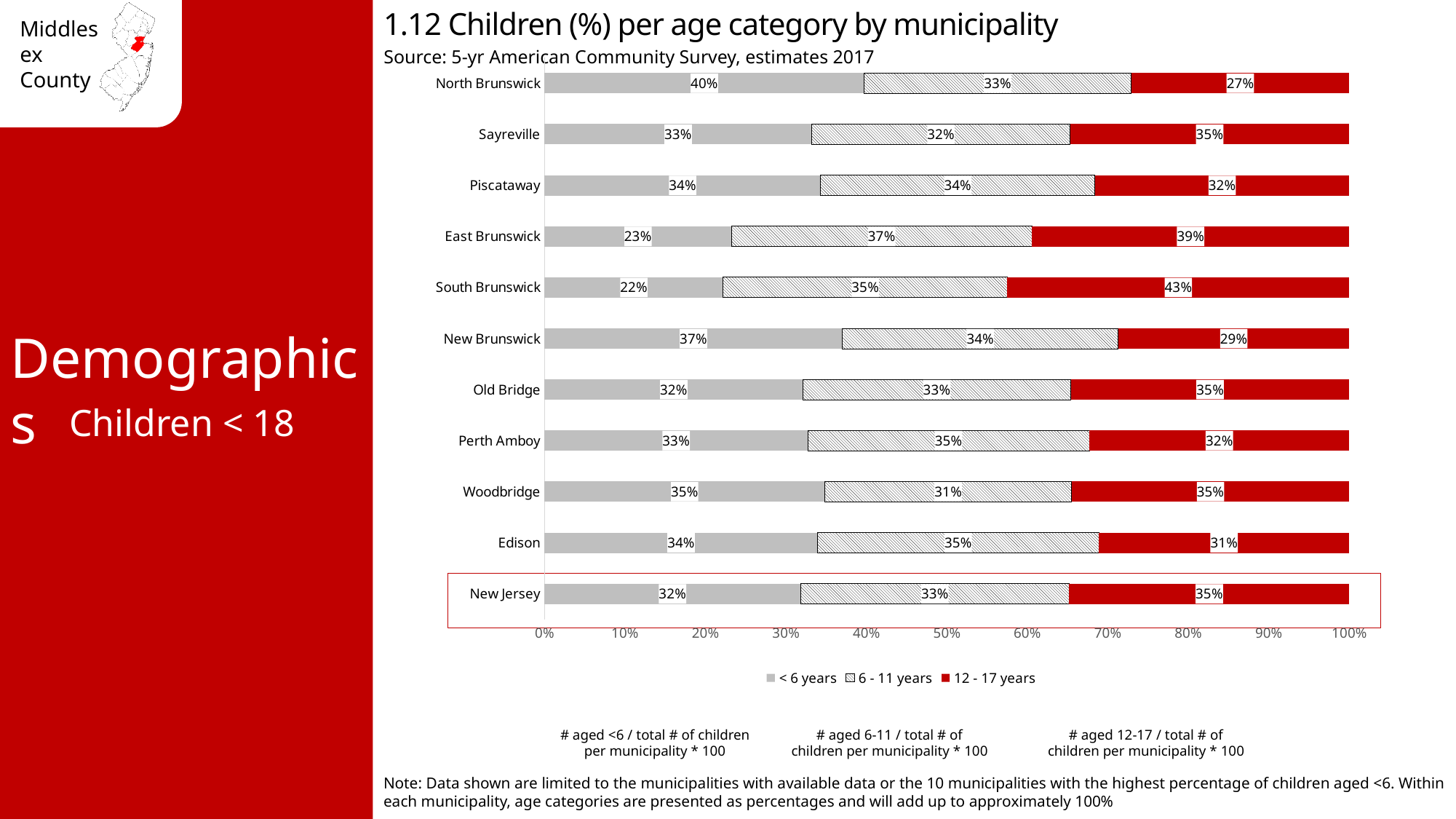
What kind of chart is shown on the slide? Stacked bar chart Which is larger: the 12 - 17 years value for East Brunswick or for New Brunswick? East Brunswick Which category has the lowest value for the 12 - 17 years series? North Brunswick Which municipality has the highest percentage of children under 6 years? North Brunswick Which municipality has the lowest percentage of children under 6 years? South Brunswick What percentage of children in North Brunswick are under 6 years old? 40% What is the value for the 12 - 17 years series for South Brunswick? 43% What is the difference between the under 6 years percentage for North Brunswick and for South Brunswick? 18 percentage points How many categories (municipalities plus New Jersey) are shown on the chart? 11 What percentage of children in East Brunswick are aged 6 - 11 years? 37% How many series does the legend list? 3 What is the total of the three stacked segments for North Brunswick? 100%